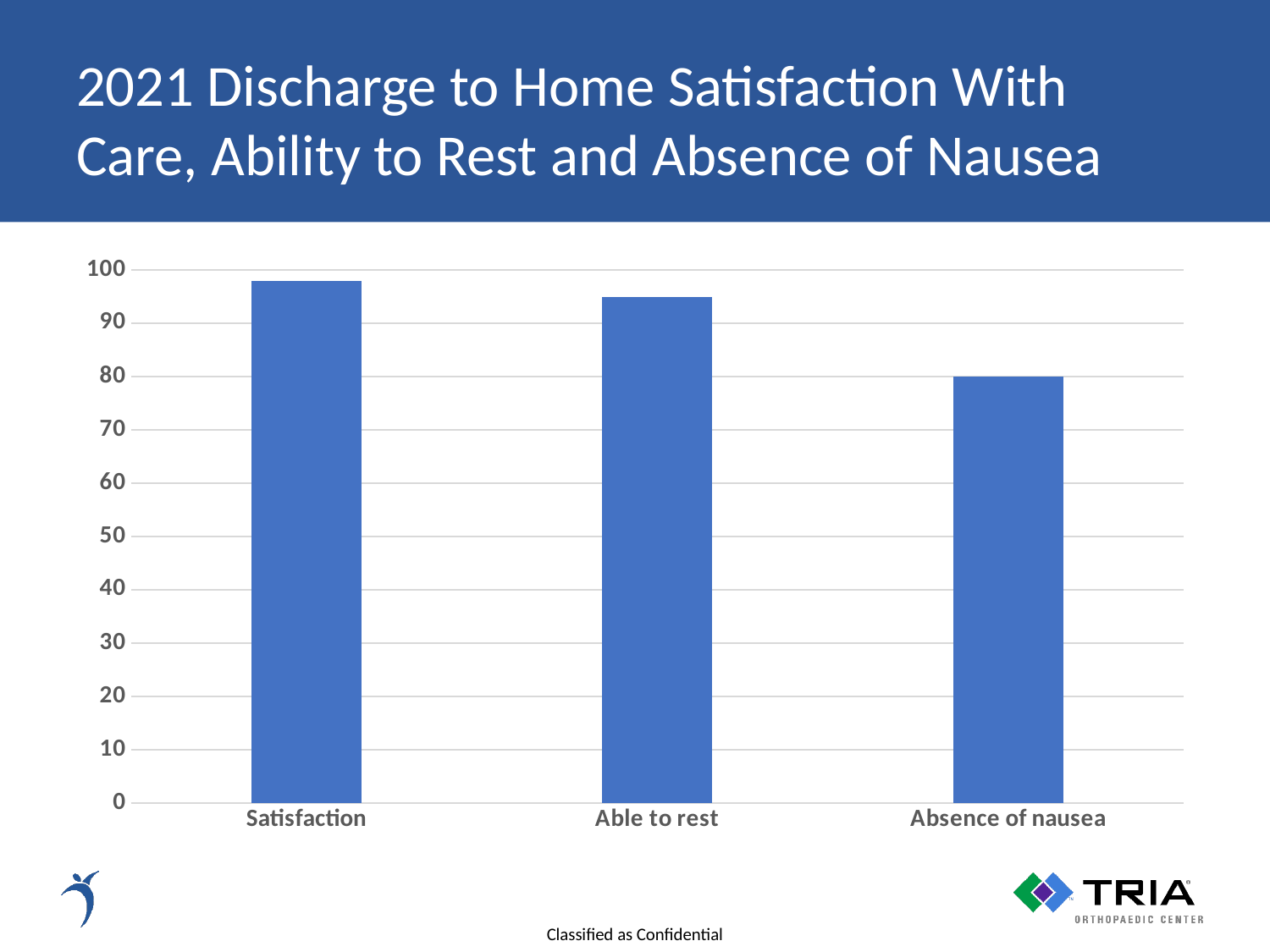
Which category has the lowest value in the chart? Absence of nausea Is the value for Absence of nausea greater or less than 90? less What is the title of the slide containing the chart? 2021 Discharge to Home Satisfaction With Care, Ability to Rest and Absence of Nausea Do the bar values rise or fall from left to right across the chart? Fall Is the value for Able to rest greater or less than 90? greater What kind of chart is shown on the slide? Bar chart Is the value for Satisfaction greater or less than 90? greater What is the value for Absence of nausea? 80 Which is larger, the value for Satisfaction or the value for Able to rest? Satisfaction How many categories are shown on the x axis of the chart? 3 Which category has the highest value in the chart? Satisfaction